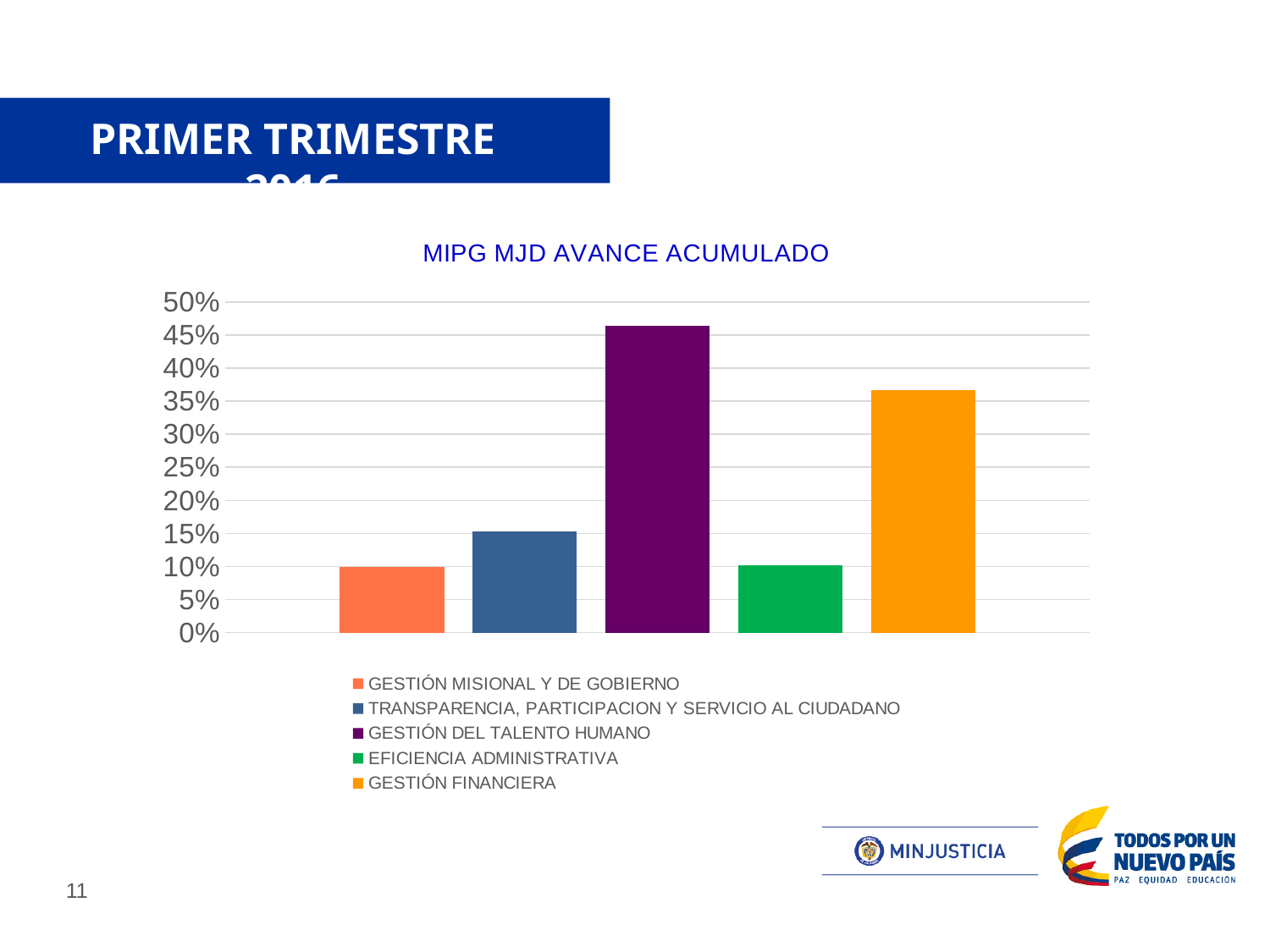
How many bars are plotted in the chart? 5 What colour is the bar for GESTIÓN DEL TALENTO HUMANO? purple Is the value for EFICIENCIA ADMINISTRATIVA greater or less than 5%? greater Which category has the highest value? GESTIÓN DEL TALENTO HUMANO What is the title of the chart? MIPG MJD AVANCE ACUMULADO What kind of chart is shown on the slide? bar chart Is the value for GESTIÓN DEL TALENTO HUMANO greater or less than 40%? greater Which is larger, the value for GESTIÓN FINANCIERA or the value for TRANSPARENCIA, PARTICIPACION Y SERVICIO AL CIUDADANO? GESTIÓN FINANCIERA How many series does the legend list? 5 Is the value for TRANSPARENCIA, PARTICIPACION Y SERVICIO AL CIUDADANO greater or less than 20%? less